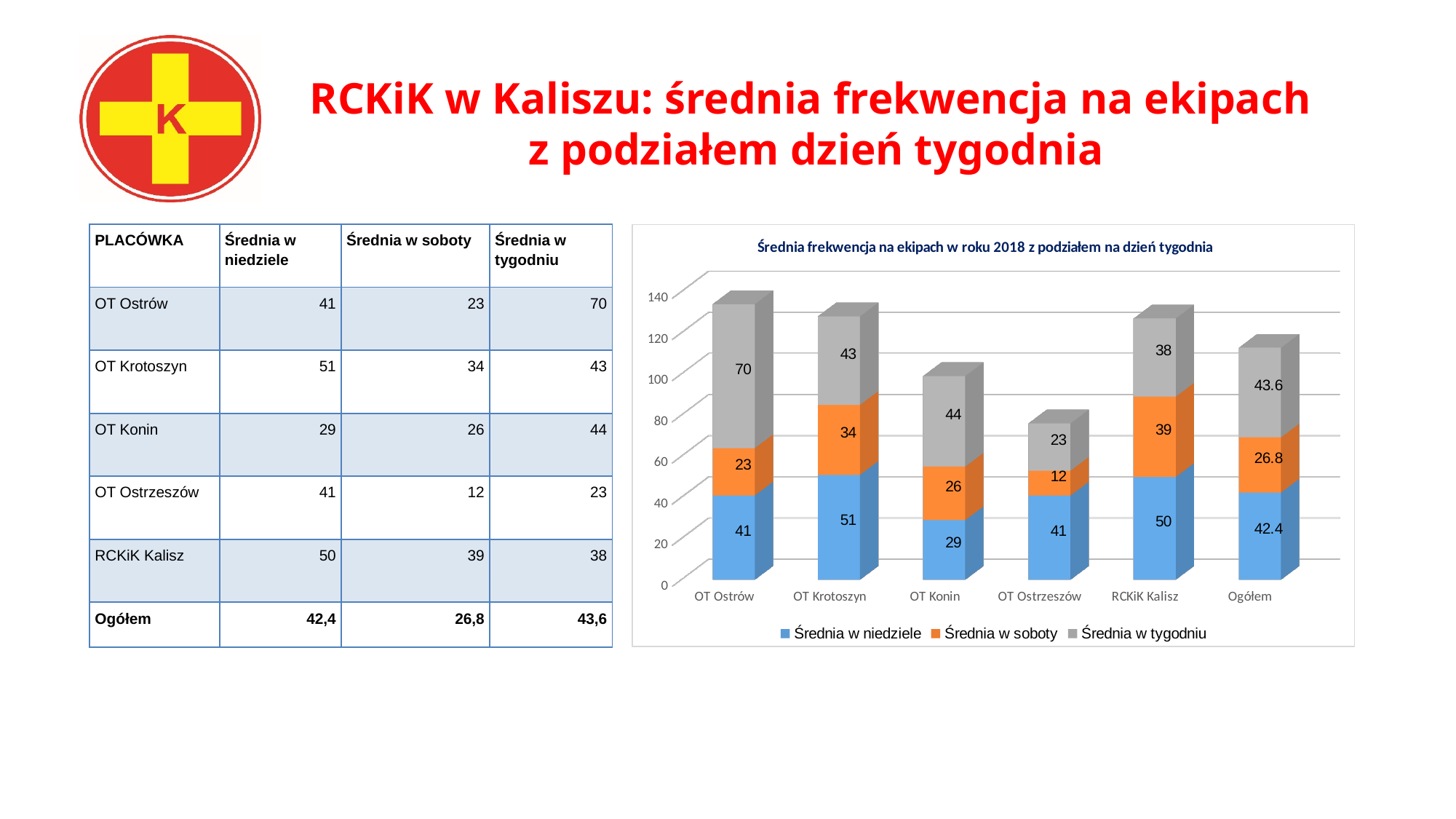
What is the difference between the "Średnia w tygodniu" values for OT Ostrów and OT Ostrzeszów in the chart? 47 What is the value of "Średnia w tygodniu" for OT Ostrów in the chart? 70 Which is larger in the chart: "Średnia w soboty" for OT Krotoszyn or for OT Konin? OT Krotoszyn What is the total height of the stacked bar for OT Ostrzeszów in the chart? 76 Which category has the highest value for "Średnia w niedziele" in the chart? OT Krotoszyn What is the value of "Średnia w niedziele" for Ogółem in the chart? 42.4 What is the value of "Średnia w soboty" for RCKiK Kalisz in the chart? 39 Which category has the lowest value for "Średnia w soboty" in the chart? OT Ostrzeszów How many series does the chart legend list? 3 What is the total height of the stacked bar for OT Konin in the chart? 99 How many categories are shown on the x axis of the chart? 6 What kind of chart is shown on the slide? Stacked bar chart